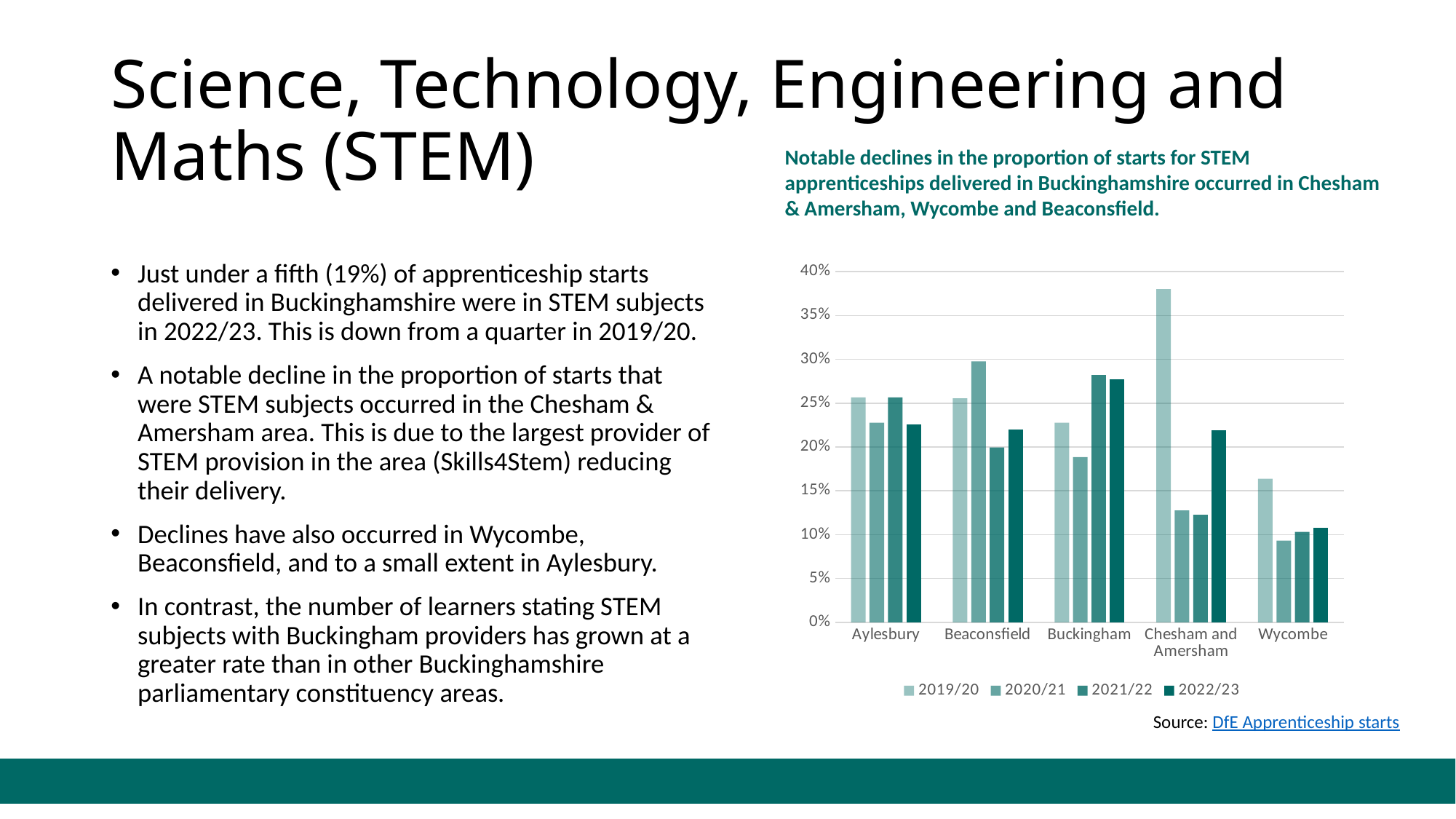
Which area has the highest 2021/22 bar? Buckingham Which area has the highest 2019/20 bar? Chesham and Amersham How many constituency areas are shown on the x axis of the chart? 5 Which is larger, the 2020/21 value for Beaconsfield or the 2020/21 value for Aylesbury? Beaconsfield Does the value for Chesham and Amersham rise or fall from 2019/20 to 2020/21? fall Is the 2021/22 value for Buckingham greater or less than 25%? greater What is the first entry in the chart's legend? 2019/20 How many series does the legend list? 4 Which area has the lowest 2020/21 bar? Wycombe What kind of chart is shown on the slide? bar chart Is the 2019/20 value for Chesham and Amersham greater or less than 35%? greater Is the 2020/21 value for Wycombe greater or less than 10%? less